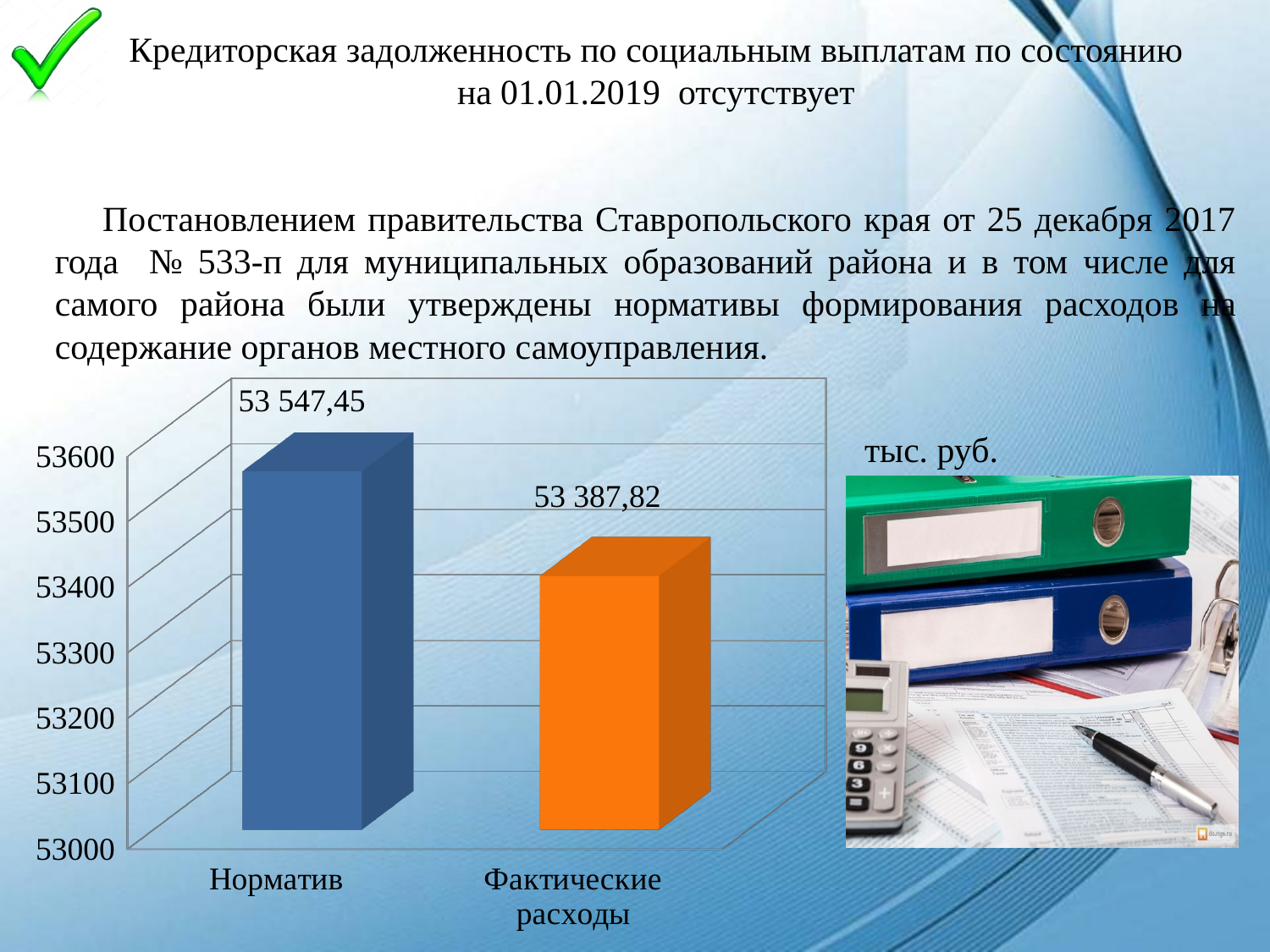
Is the value for Фактические расходы greater or less than 53400? less Which is larger, the value for Норматив or the value for Фактические расходы? Норматив What is the value for Фактические расходы? 53 387,82 How many categories are shown in the chart? 2 What is the value for Норматив? 53 547,45 Which category has the lowest value? Фактические расходы Is the value for Норматив greater or less than 53500? greater What kind of chart is shown on the slide? bar chart What unit is indicated next to the chart? тыс. руб. Which category has the highest value? Норматив What is the difference between the values for Норматив and Фактические расходы? 159,63 What colour is the bar for Фактические расходы? orange